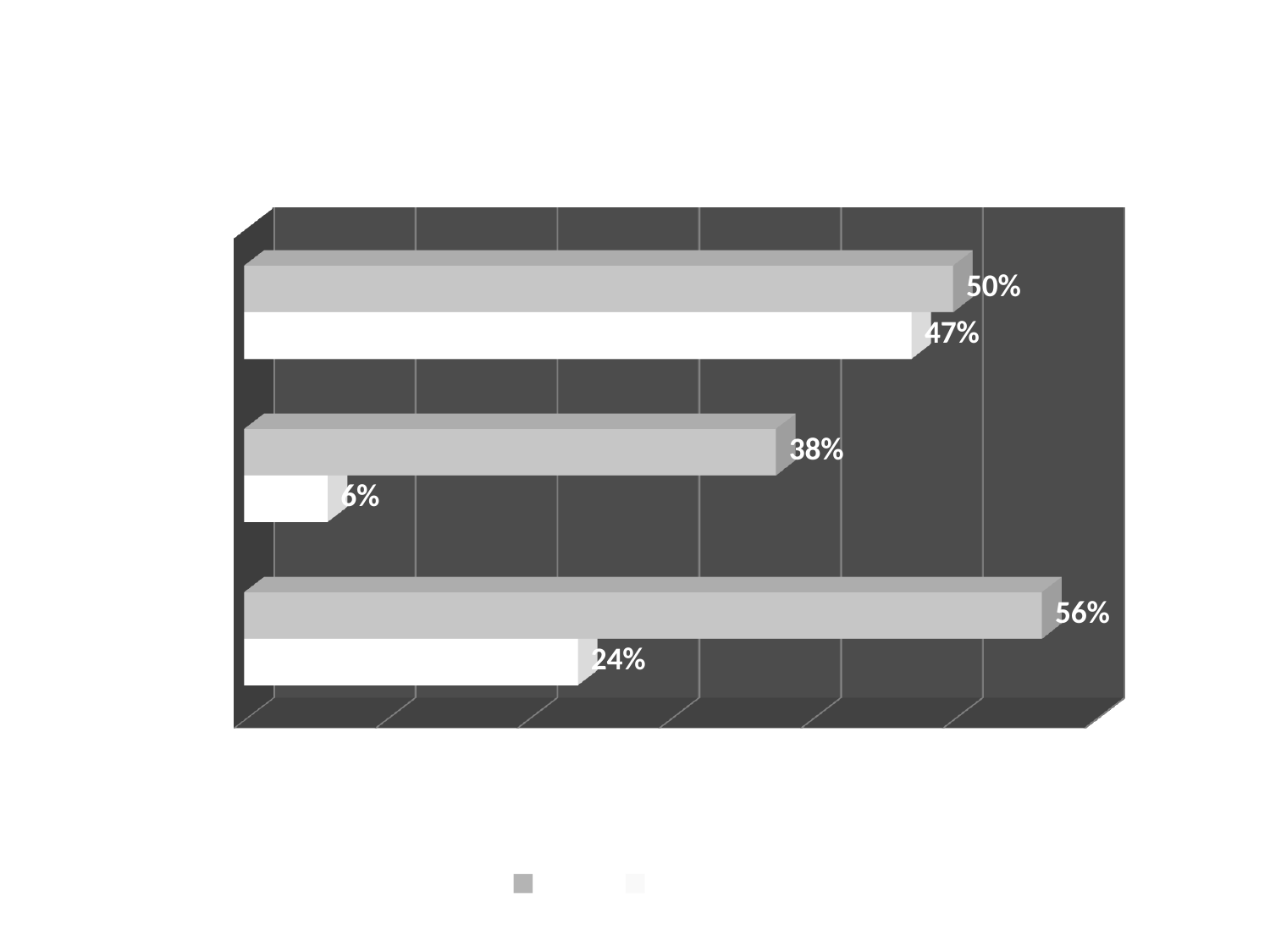
Which bar has the lowest value in the chart? the white bar in the middle group (6%) What is the value of the white bar in the middle group? 6% What is the value of the white bar in the top group? 47% What is the value of the white bar in the bottom group? 24% What is the value of the grey bar in the middle group? 38% What is the value of the grey bar in the bottom group? 56% Which bar has the highest value in the chart? the grey bar in the bottom group (56%) What is the difference between the grey and white bars in the middle group? 32% What is the value of the grey bar in the top group? 50% How many series does the legend show? 2 How many groups of bars are plotted in the chart? 3 What kind of chart is shown on the slide? bar chart